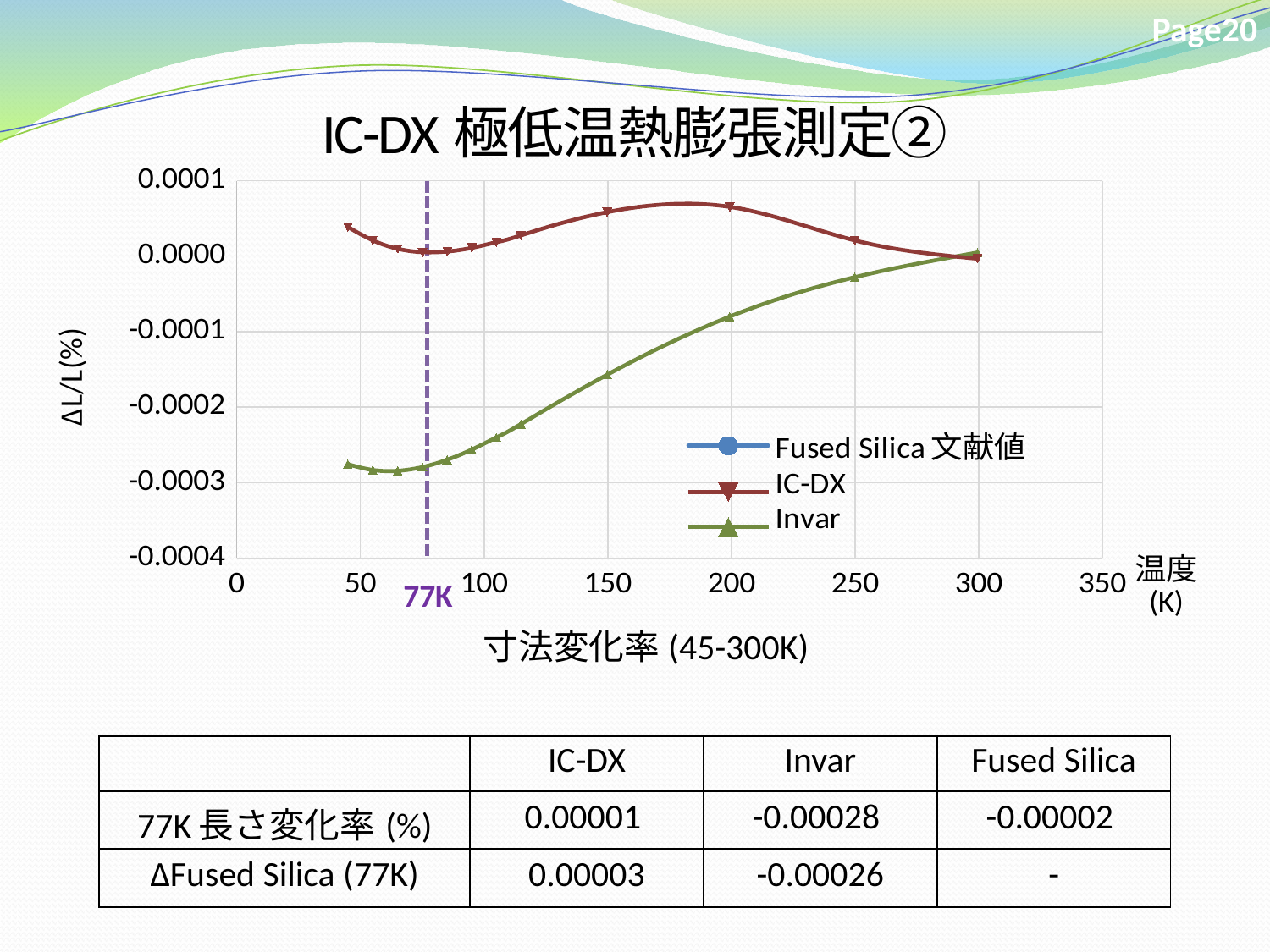
Is the Invar value at 100 K greater or less than -0.0002? less According to the slide, what is the 77K length change rate (%) for IC-DX? 0.00001 What temperature does the dashed vertical line on the chart mark? 77K Is the IC-DX value at 200 K greater or less than 0.0000? greater Does the Invar series rise or fall as temperature increases from 100 K to 300 K? rise Is the Invar value at 50 K greater or less than -0.0002? less What are the three series listed in the chart legend? Fused Silica 文献値, IC-DX, Invar According to the slide, what is the 77K length change rate (%) for Invar? -0.00028 What kind of chart is shown on the slide? line chart At 150 K, which series has the higher ΔL/L value, IC-DX or Invar? IC-DX How many series does the chart legend list? 3